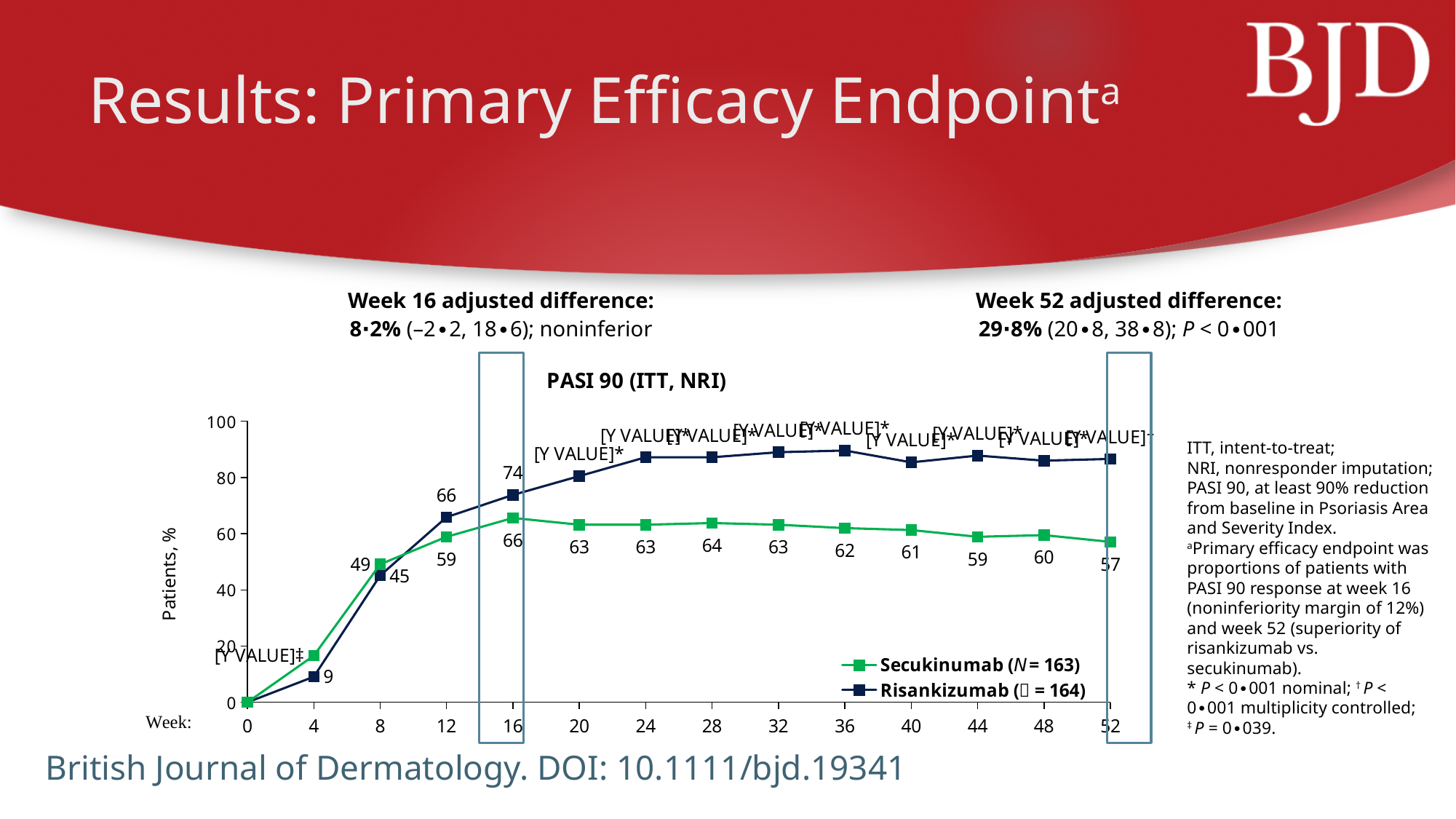
What is the value for Secukinumab at week 52? 57 What is the value for Secukinumab at week 12? 59 At week 8, which series has the higher value, Secukinumab or Risankizumab? Secukinumab How many series does the chart legend list? 2 How many week time points are shown on the x axis? 14 What is the difference between the Risankizumab and Secukinumab values at week 16? 8 What is the value for Risankizumab at week 16? 74 Is the value for Risankizumab at week 52 greater or less than 80? greater What is the title of the chart? PASI 90 (ITT, NRI) What is the value for Risankizumab at week 4? 9 What kind of chart is shown on the slide? line chart What is the value for Secukinumab at week 16? 66